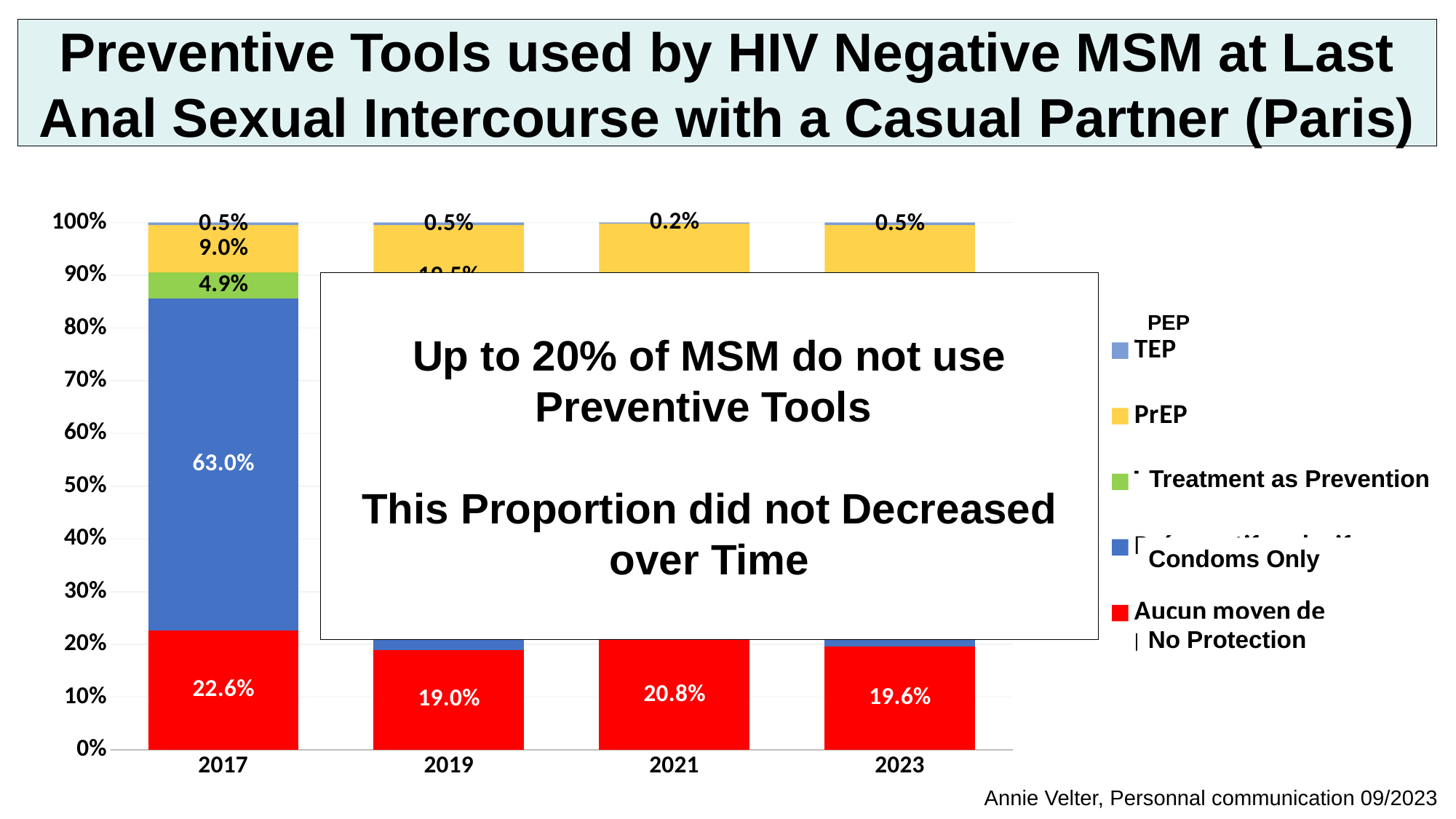
What percentage of HIV negative MSM used No Protection in 2017? 22.6% What percentage used Condoms Only in 2017? 63.0% What is the difference between the No Protection values for 2017 and 2019? 3.6% Which year has the highest No Protection percentage? 2017 Which year has a larger No Protection value, 2021 or 2023? 2021 What is the No Protection value for 2021? 20.8% How many years are shown on the x axis? 4 Which year has the lowest No Protection percentage? 2019 What is the PEP/TEP value for 2021? 0.2% What is the Treatment as Prevention value for 2017? 4.9% What is the PrEP value for 2017? 9.0% What kind of chart is shown on the slide? Stacked bar chart